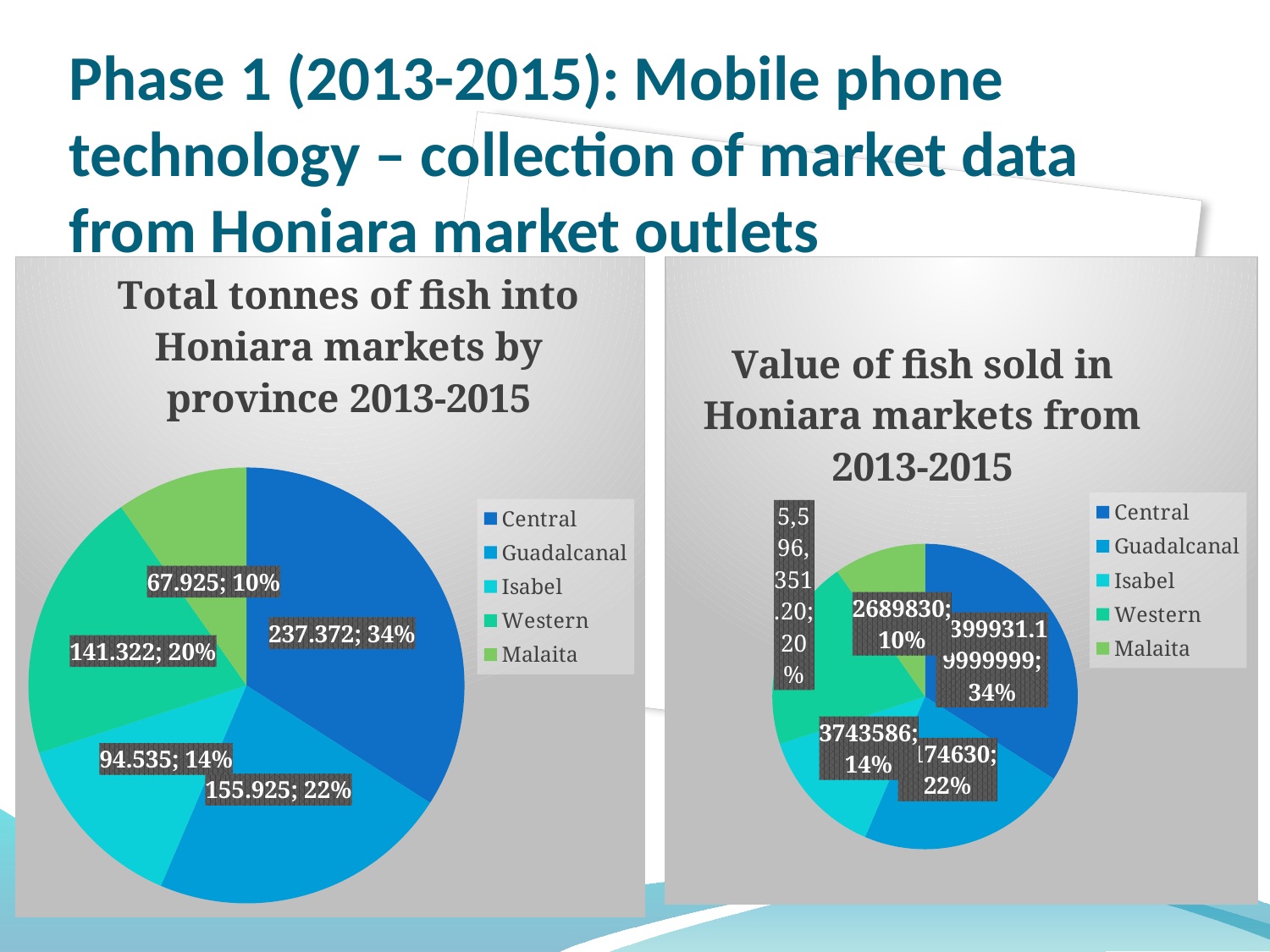
In the chart 'Total tonnes of fish into Honiara markets by province 2013-2015', what percentage share does Isabel have? 14% How many entries does the legend of the chart 'Value of fish sold in Honiara markets from 2013-2015' list? 5 In the chart 'Total tonnes of fish into Honiara markets by province 2013-2015', which province has the smallest slice? Malaita In the chart 'Total tonnes of fish into Honiara markets by province 2013-2015', what is the difference between the Central and Guadalcanal values? 81.447 In the chart 'Value of fish sold in Honiara markets from 2013-2015', what value is shown for Malaita? 2689830 In the chart 'Value of fish sold in Honiara markets from 2013-2015', what percentage share does Western have? 20% What type of chart is 'Value of fish sold in Honiara markets from 2013-2015'? Pie chart In the chart 'Total tonnes of fish into Honiara markets by province 2013-2015', which is larger, Western or Guadalcanal? Guadalcanal In the chart 'Total tonnes of fish into Honiara markets by province 2013-2015', what value is shown for Central? 237.372 In the chart 'Total tonnes of fish into Honiara markets by province 2013-2015', what value is shown for Western? 141.322 In the chart 'Total tonnes of fish into Honiara markets by province 2013-2015', which province has the largest slice? Central How many provinces are shown in the chart 'Total tonnes of fish into Honiara markets by province 2013-2015'? 5